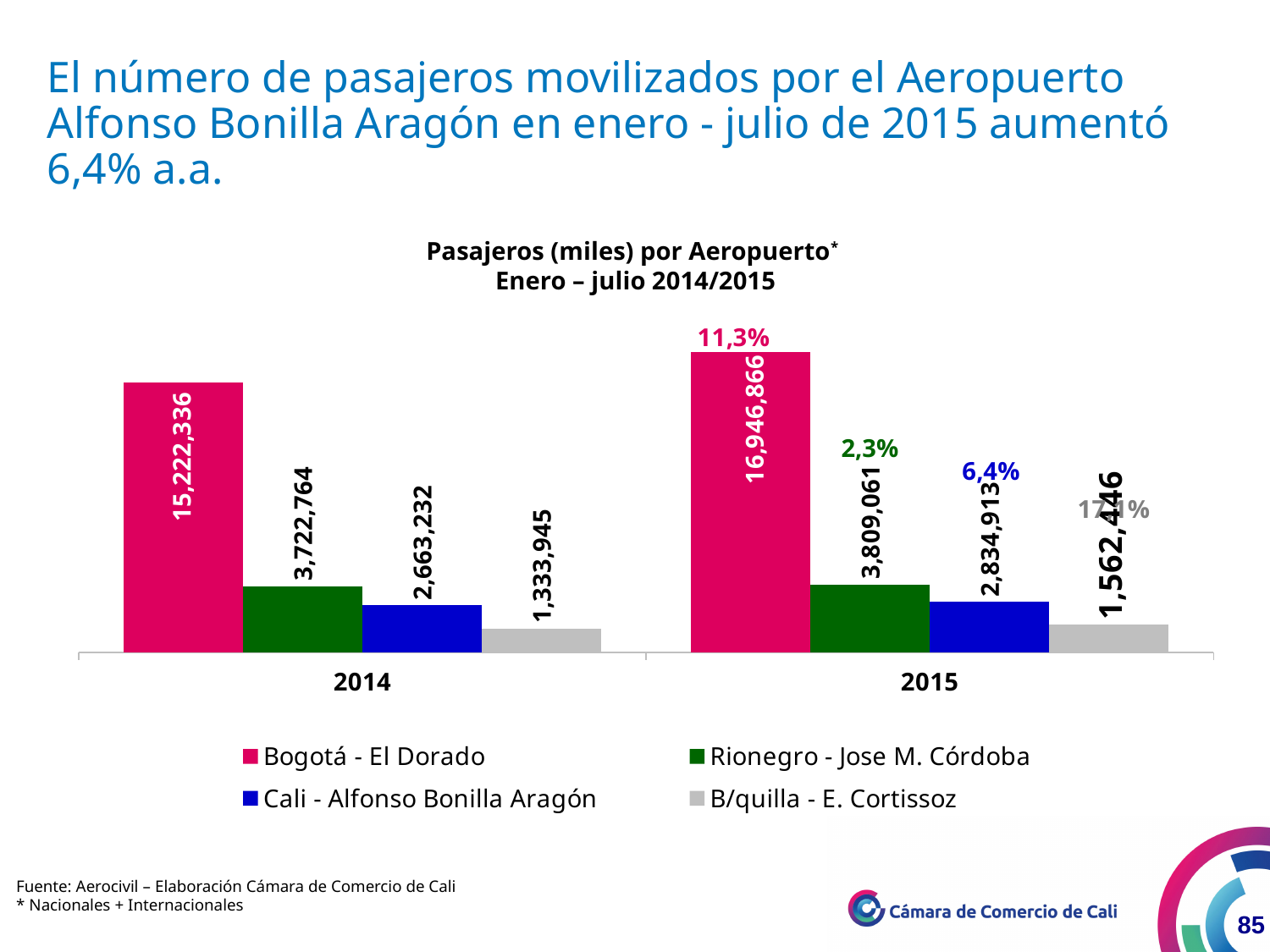
Which airport has the lowest value in 2014? B/quilla - E. Cortissoz How many series does the legend list? 4 What is the value for Bogotá - El Dorado in 2014? 15,222,336 Which airport has the highest value in 2015? Bogotá - El Dorado What is the value for Rionegro - Jose M. Córdoba in 2015? 3,809,061 What is the value for Cali - Alfonso Bonilla Aragón in 2015? 2,834,913 How many year categories are shown on the x axis? 2 Which is larger, the Rionegro - Jose M. Córdoba value in 2014 or the Cali - Alfonso Bonilla Aragón value in 2015? Rionegro - Jose M. Córdoba in 2014 What type of chart is shown on the slide? Bar chart What is the difference between the Cali - Alfonso Bonilla Aragón values for 2015 and 2014? 171,681 What is the value for B/quilla - E. Cortissoz in 2014? 1,333,945 What is the title of the chart? Pasajeros (miles) por Aeropuerto* Enero – julio 2014/2015